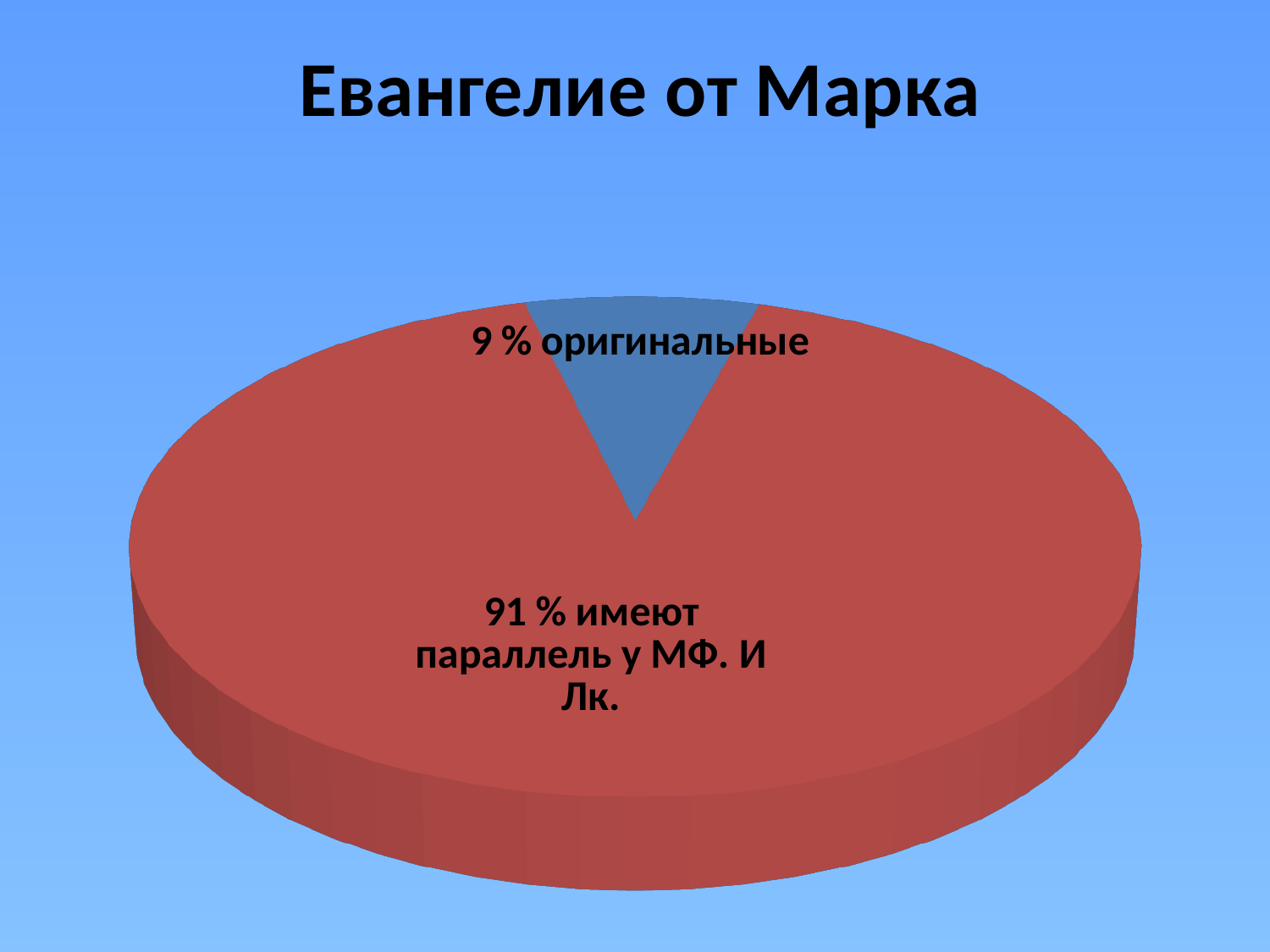
What is the total of the two slice percentages? 100 % How many slices does the pie chart have? 2 What is the title of the chart? Евангелие от Марка What colour is the slice labelled "9 % оригинальные"? blue What share of the pie is labelled "имеют параллель у МФ. И Лк."? 91 % What is the difference between the two slices' percentages? 82 % What share of the pie is labelled "оригинальные"? 9 % Which slice is the smallest? 9 % оригинальные What kind of chart is shown on the slide? pie chart Which is larger: the share of "оригинальные" or the share of "имеют параллель у МФ. И Лк."? имеют параллель у МФ. И Лк. Which slice is the largest? 91 % имеют параллель у МФ. И Лк.